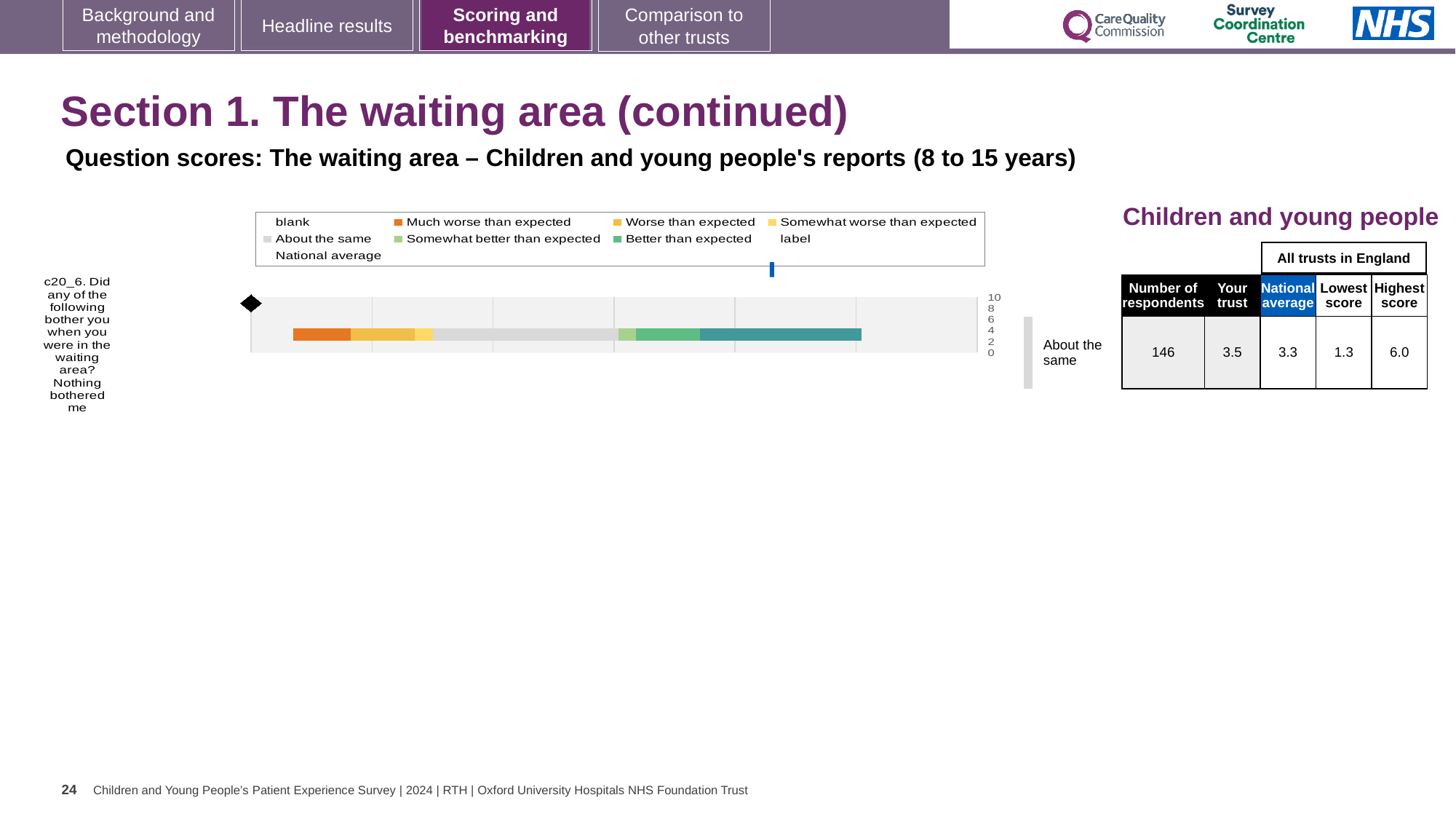
What is the national average score for question c20_6 (Nothing bothered me)? 3.3 What is the lowest score among all trusts in England for question c20_6? 1.3 How many questions (categories) are plotted in the chart? 1 What is the difference between the trust's score and the national average for question c20_6? 0.2 What is the difference between the highest and lowest scores among all trusts in England for question c20_6? 4.7 Which is larger for question c20_6: the trust's score or the national average? the trust's score Which benchmark category is the trust's result for question c20_6 labelled as on the chart? About the same How many respondents answered question c20_6 (Nothing bothered me)? 146 What is the highest score among all trusts in England for question c20_6? 6.0 How many entries does the chart legend list? 9 What kind of chart is shown on the slide? bar chart What is the 'Your trust' score for question c20_6 (Nothing bothered me)? 3.5